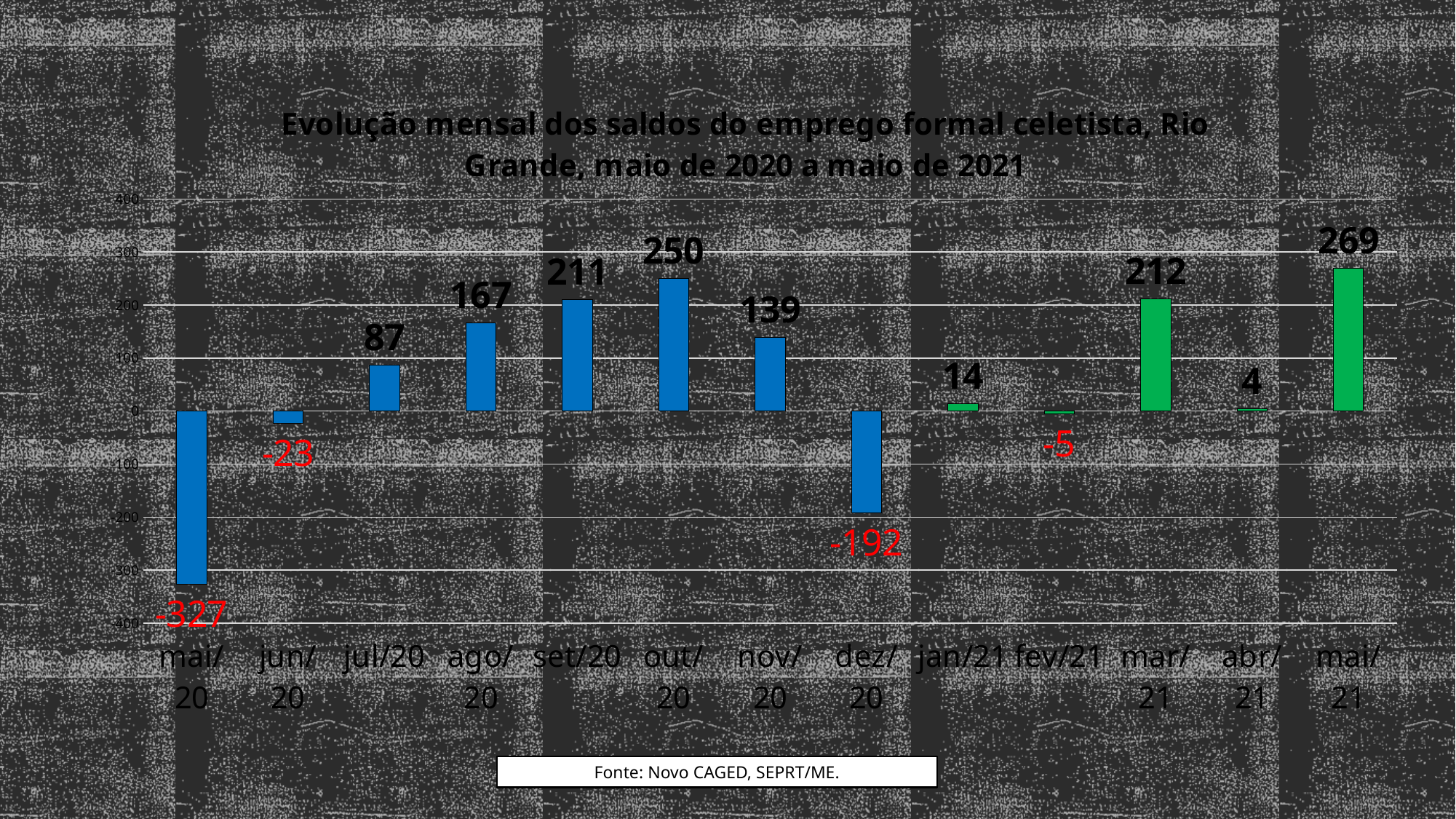
How many months are shown on the x axis? 13 Which month has the highest value? mai/21 What is the value for fev/21? -5 What is the value for mai/20? -327 What is the difference between the values for mai/21 and out/20? 19 Do the values rise or fall from mai/20 to out/20? rise Which month has the lowest value? mai/20 What kind of chart is this? bar chart Which is larger, the value for ago/20 or the value for nov/20? ago/20 What is the difference between the values for set/20 and nov/20? 72 What is the value for out/20? 250 What colour are the bars for the 2021 months? green